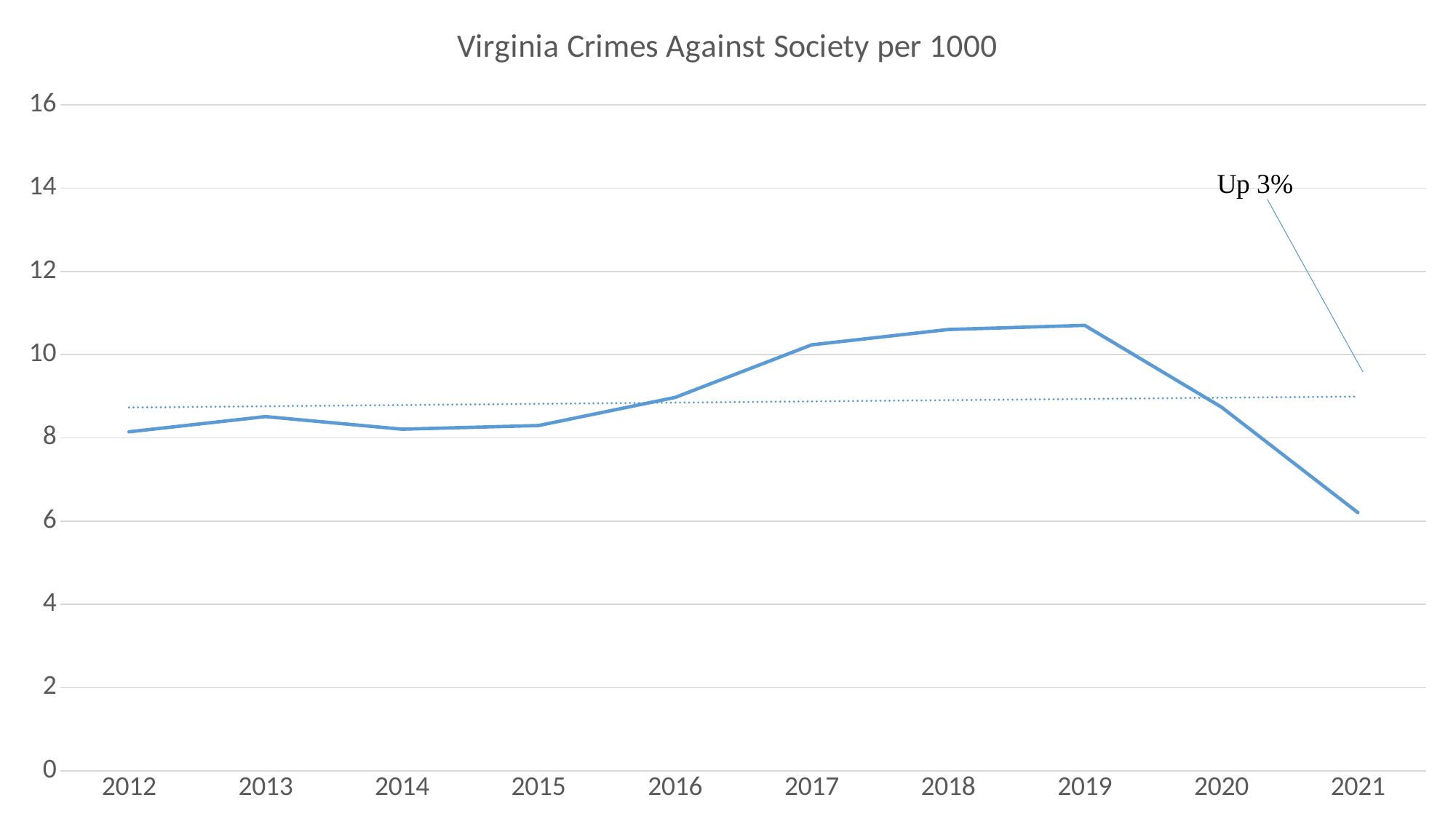
Do the values rise or fall from 2015 to 2019? rise How many years are plotted along the x axis? 10 What is the title of the chart? Virginia Crimes Against Society per 1000 Do the values rise or fall from 2019 to 2021? fall Which year has the lowest value? 2021 Is the value for 2014 greater or less than 10? less What does the text annotation near the dotted trend line say? Up 3% Is the value for 2020 greater or less than 10? less Is the value for 2019 greater or less than 10? greater What kind of chart is shown on the slide? line chart